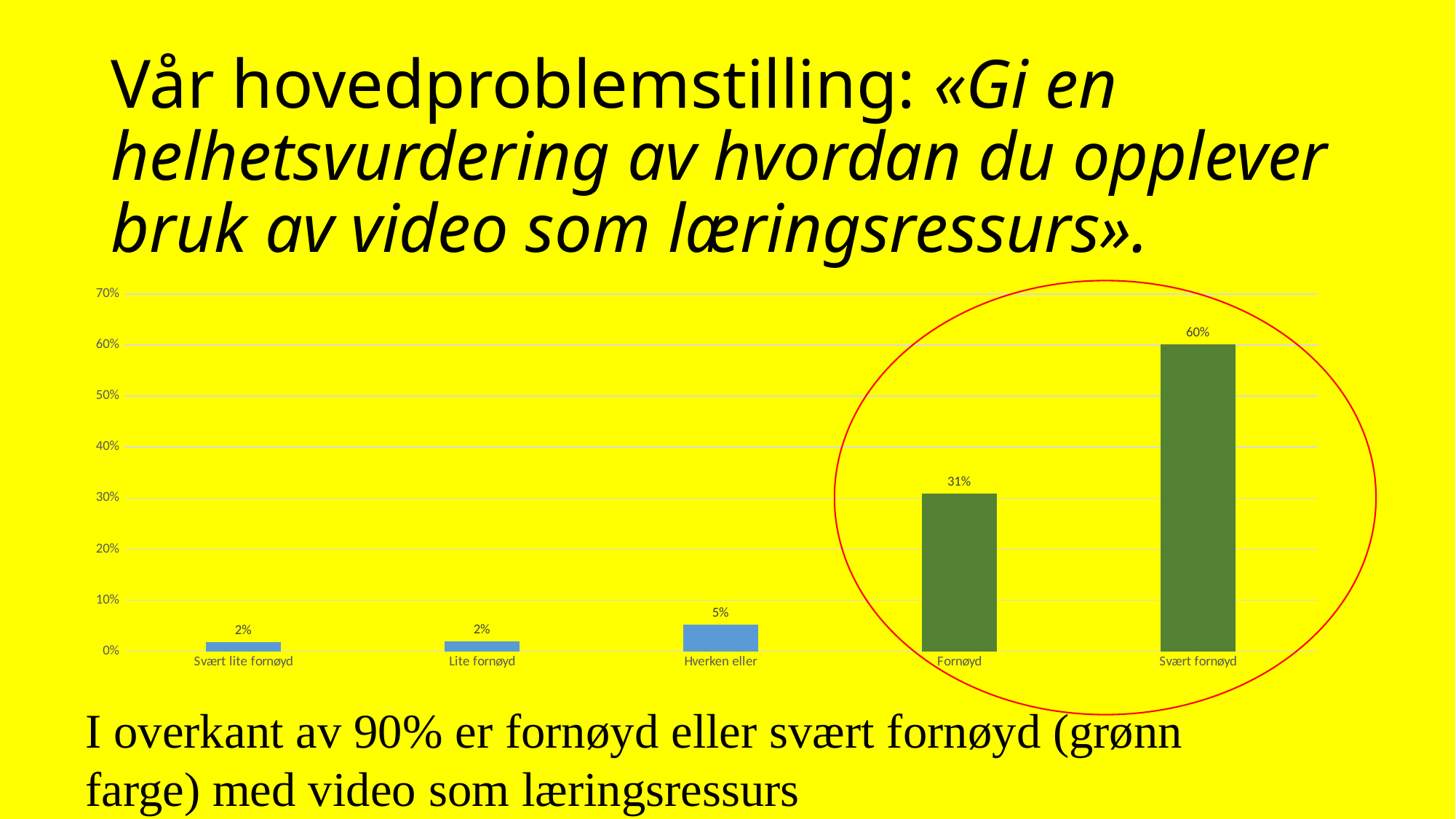
Which is larger, the value for Hverken eller or the value for Lite fornøyd? Hverken eller Is the value for Fornøyd greater or less than 40%? less What is the value for Svært fornøyd? 60% Do the values generally rise or fall from left to right along the x axis? rise What is the value for Lite fornøyd? 2% What is the value for Fornøyd? 31% What colour are the bars for Fornøyd and Svært fornøyd? green What is the value for Hverken eller? 5% What is the difference between the values for Svært fornøyd and Fornøyd? 29% How many categories are shown on the x axis? 5 What kind of chart is shown on the slide? bar chart Which category has the highest value? Svært fornøyd